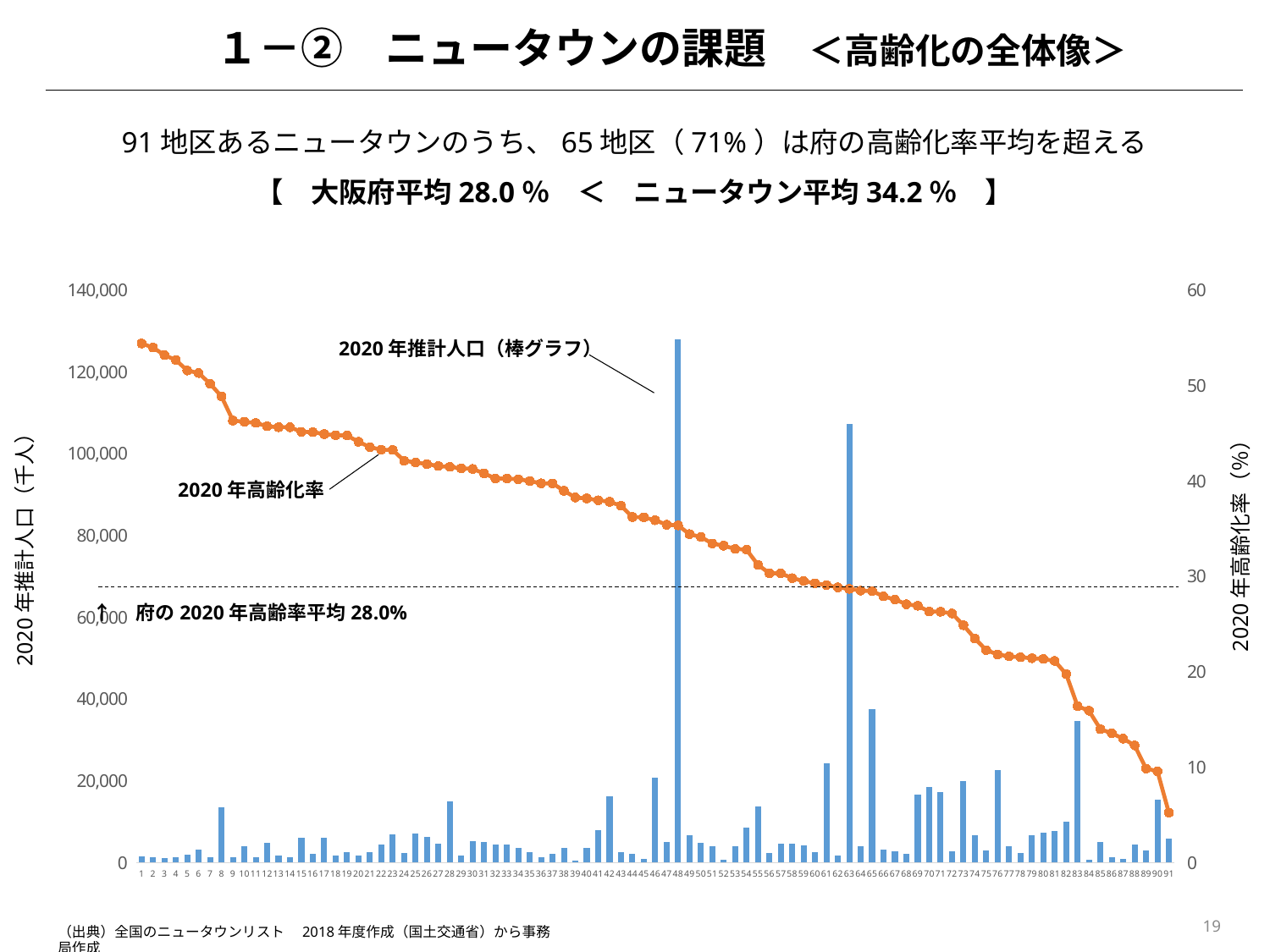
Is the 2020 estimated population bar for district 63 greater or less than 100,000? greater Which district has the lowest 2020 aging rate on the line? 91 Which has the larger 2020 estimated population bar, district 48 or district 63? District 48 Is the 2020 aging rate for district 91 greater or less than 10%? less How many districts (categories) are plotted along the x axis? 91 What kind of chart is shown on the slide? A combined bar and line chart What does the dashed horizontal line on the chart represent? 府の2020年高齢率平均 28.0% Which district has the tallest bar for 2020 estimated population (2020年推計人口)? 48 Is the 2020 estimated population bar for district 48 greater or less than 120,000? greater Does the 2020 aging rate line (2020年高齢化率) rise or fall as you move from district 1 to district 91? It falls